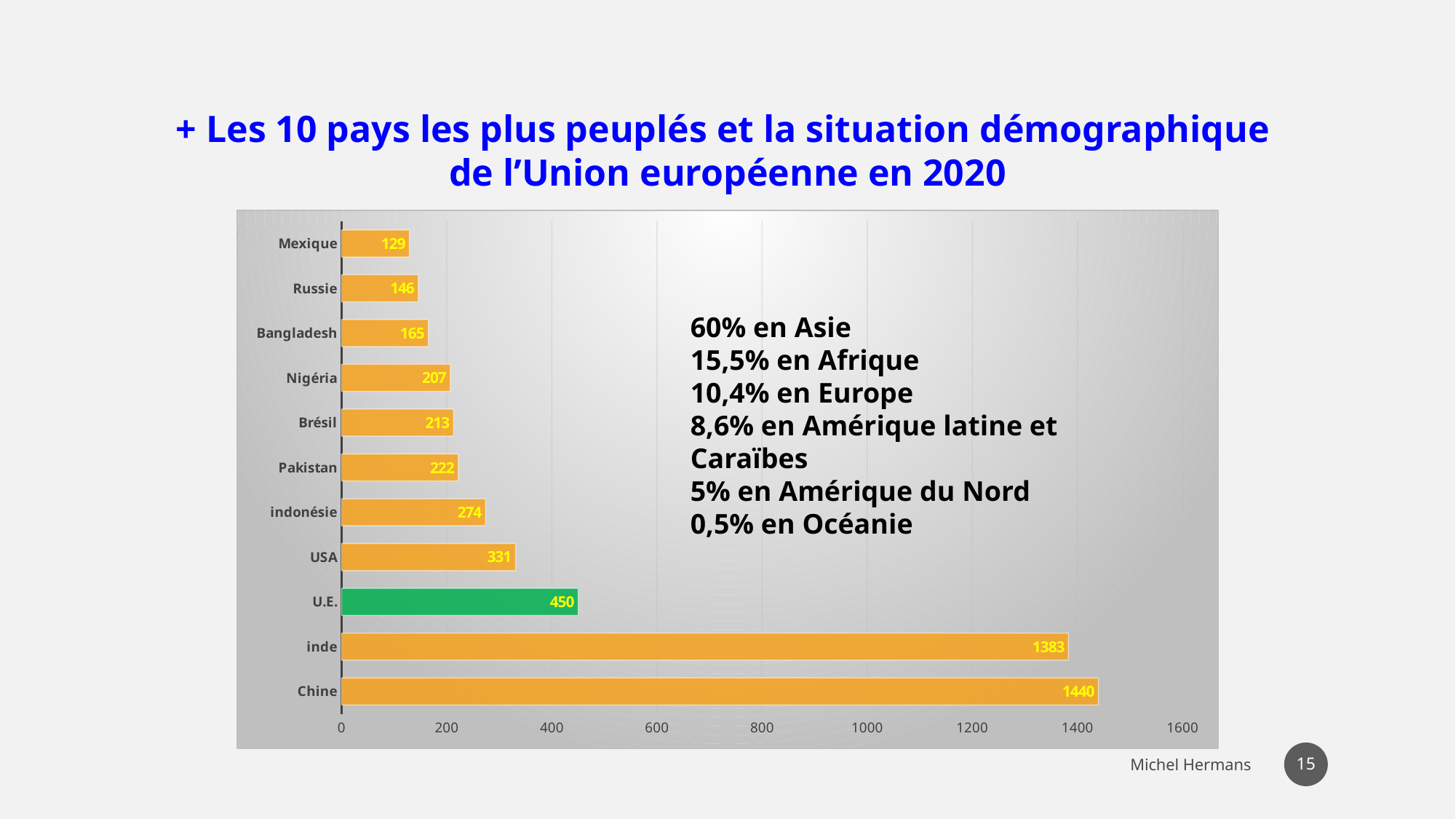
Is the value for indonésie greater or less than 200? greater What is the value for U.E.? 450 What is the difference between the values for Chine and inde? 57 Which bar is coloured green instead of orange? U.E. Which category has the lowest value? Mexique What kind of chart is shown on the slide? bar chart Which category has the highest value? Chine Which is larger, the value for Nigéria or the value for Brésil? Brésil What is the value for Chine? 1440 How many categories are shown in the chart? 11 What is the difference between the values for U.E. and USA? 119 What is the value for Pakistan? 222